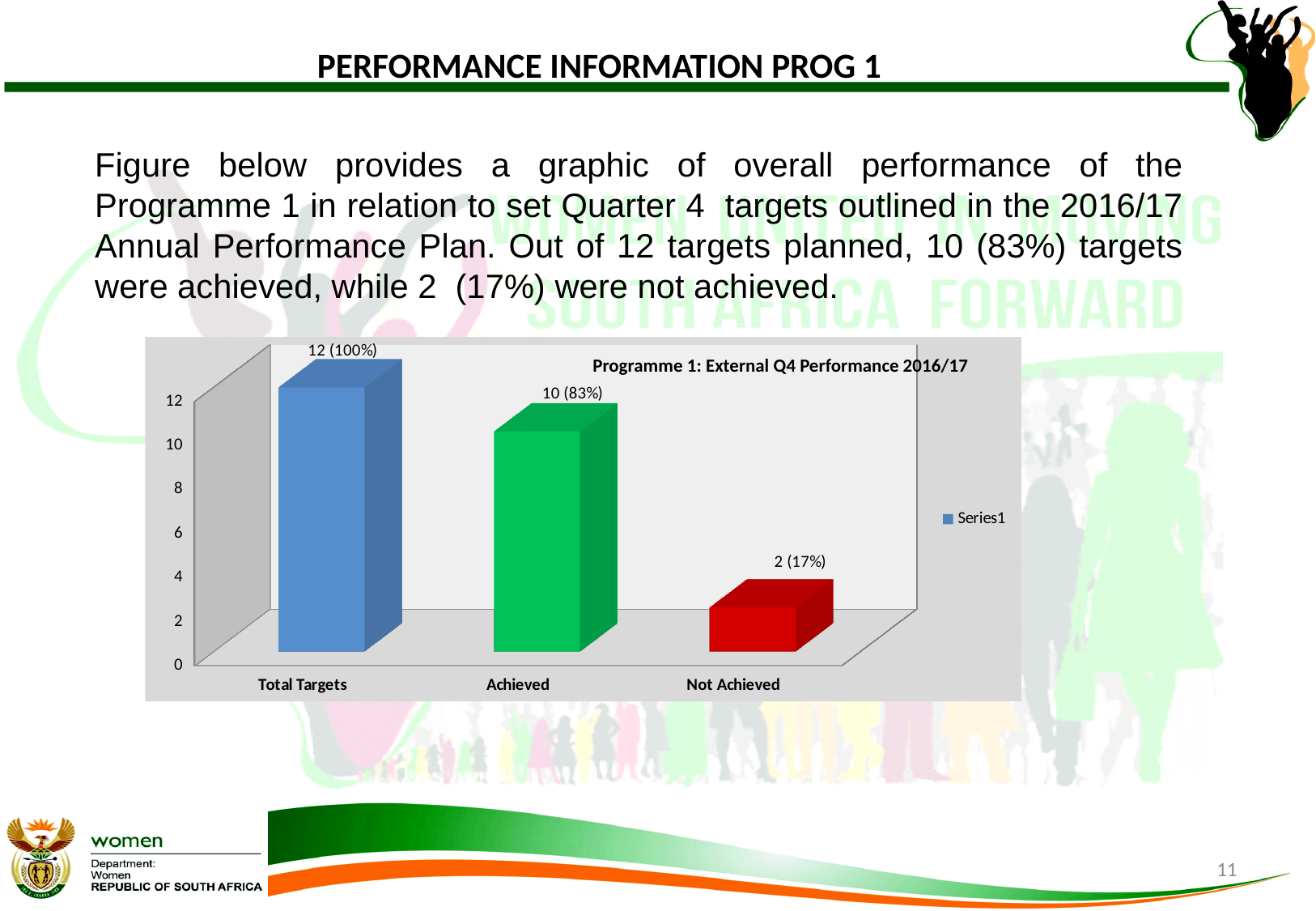
What is the value shown for Total Targets? 12 (100%) What is the value shown for Not Achieved? 2 (17%) How many categories are shown on the x axis? 3 Which category has the lowest value? Not Achieved How many series does the legend list? 1 What is the value shown for Achieved? 10 (83%) What is the difference between the Achieved and Not Achieved values? 8 Which category has the highest value? Total Targets What is the title of the chart? Programme 1: External Q4 Performance 2016/17 Which is larger, the value for Achieved or the value for Not Achieved? Achieved What kind of chart is shown on the slide? Bar chart Is the value for Achieved greater or less than 8? greater